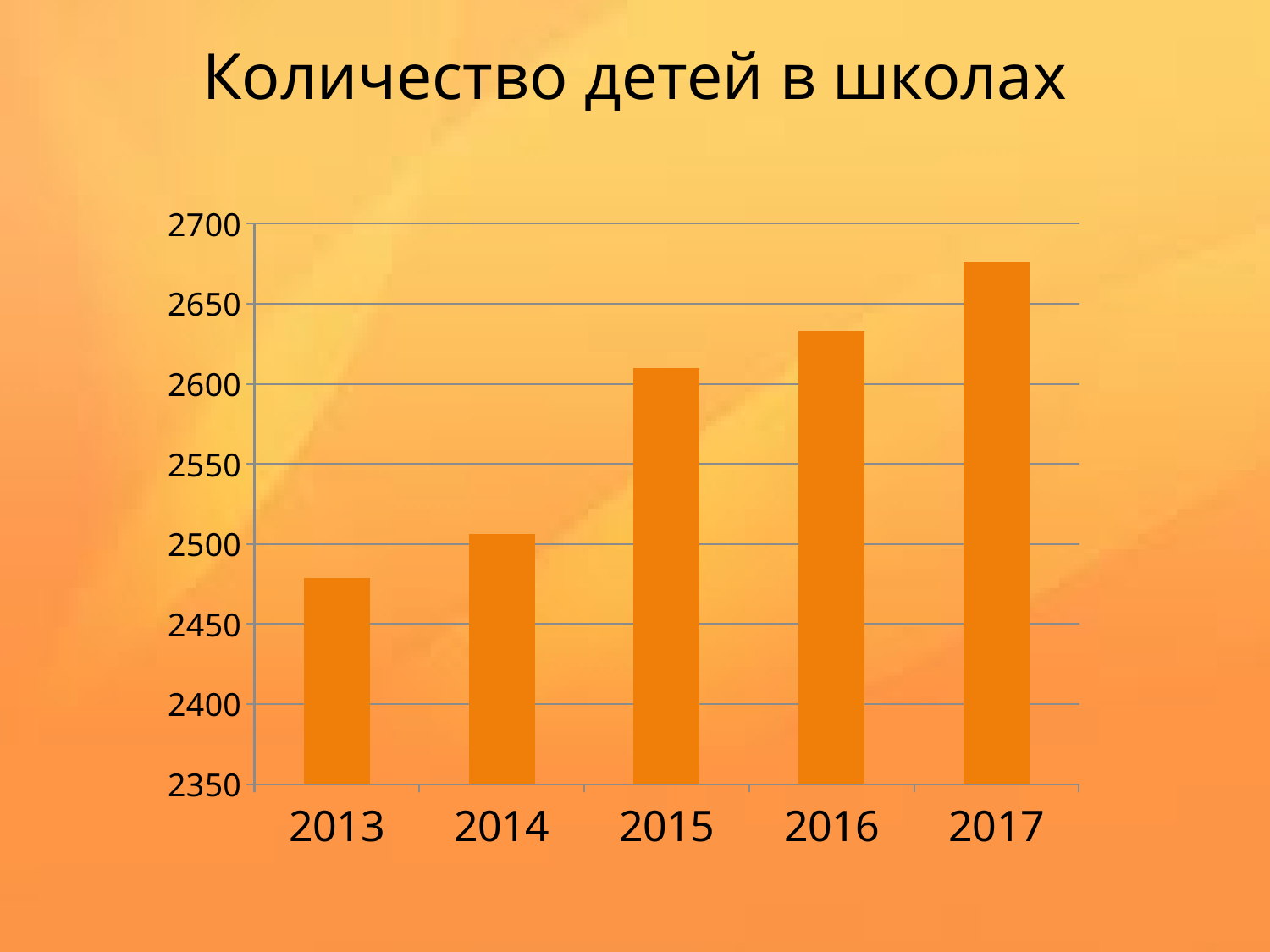
Which year has the highest value in the chart? 2017 Is the value for 2017 greater or less than 2650? greater Is the value for 2013 greater or less than 2500? less Is the value for 2015 greater or less than 2550? greater What kind of chart is shown on the slide? bar chart Which year has the lowest value in the chart? 2013 What is the title of the chart? Количество детей в школах Do the values rise or fall from 2013 to 2017? rise How many years are shown on the x axis of the chart? 5 Which is larger, the value for 2014 or the value for 2016? 2016